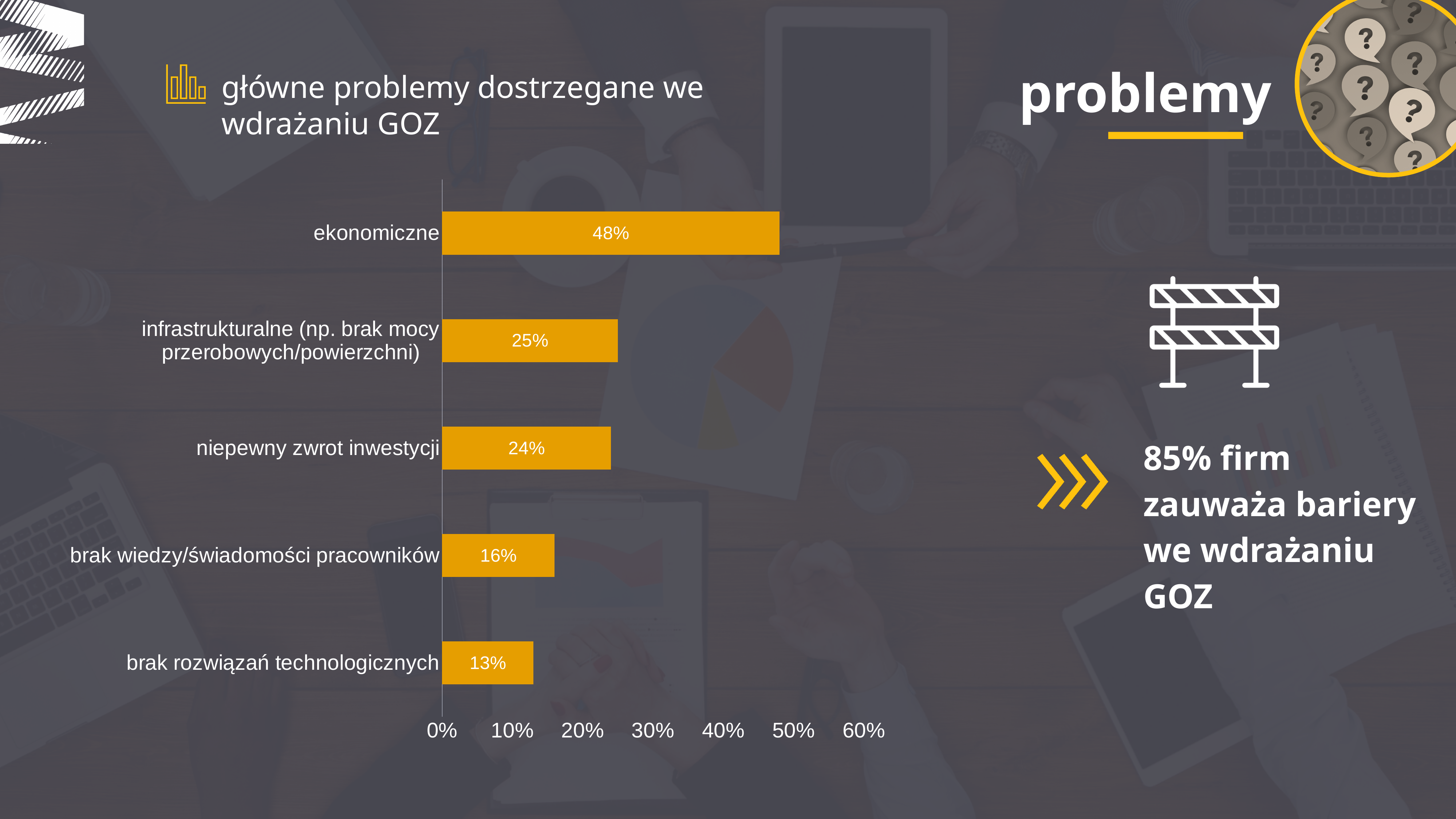
What is the title of the chart? główne problemy dostrzegane we wdrażaniu GOZ What is the value for "ekonomiczne"? 48% What is the difference between the values for "ekonomiczne" and "infrastrukturalne (np. brak mocy przerobowych/powierzchni)"? 23% Which category has the lowest value? brak rozwiązań technologicznych How many categories are shown in the chart? 5 What is the value for "niepewny zwrot inwestycji"? 24% Which category has the highest value? ekonomiczne Is the value for "ekonomiczne" greater or less than 40%? greater What is the value for "brak wiedzy/świadomości pracowników"? 16% Which is larger: the value for "brak wiedzy/świadomości pracowników" or the value for "brak rozwiązań technologicznych"? brak wiedzy/świadomości pracowników What kind of chart is shown on the slide? bar chart What is the value for "brak rozwiązań technologicznych"? 13%